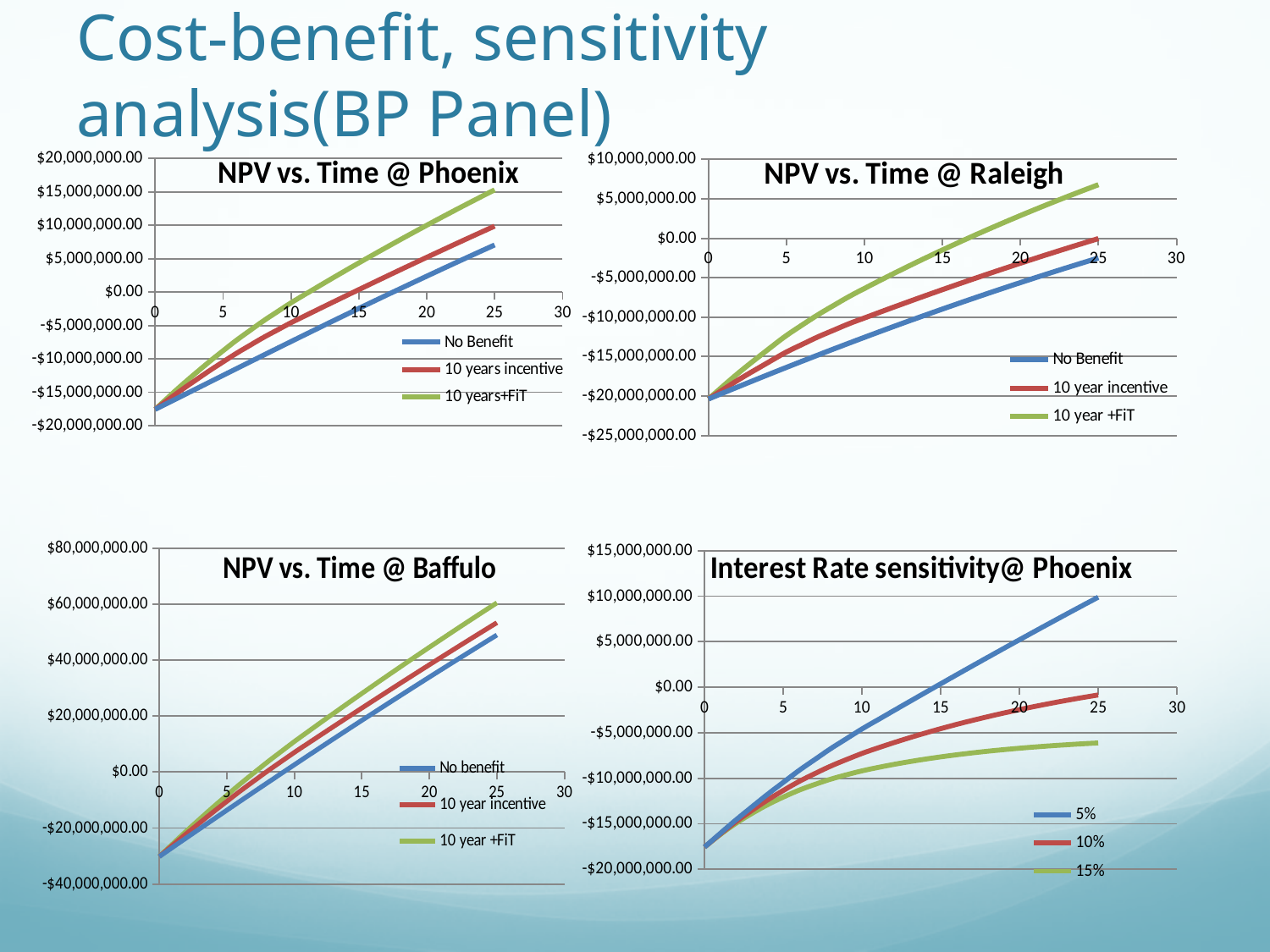
In 'NPV vs. Time @ Phoenix', does the 'No Benefit' line rise or fall as time increases along the x axis? rise In 'Interest Rate sensitivity@ Phoenix', at year 25, which series is higher: '5%' or '15%'? 5% In 'NPV vs. Time @ Raleigh', what are the legend entries? No Benefit, 10 year incentive, 10 year +FiT In 'Interest Rate sensitivity@ Phoenix', how many series does the legend list? 3 In 'Interest Rate sensitivity@ Phoenix', is the value of the '15%' series at year 25 greater or less than -$10,000,000.00? greater How many charts are shown on the slide? 4 In 'NPV vs. Time @ Phoenix', is the value of '10 years+FiT' at year 25 greater or less than $10,000,000.00? greater What kind of chart is 'NPV vs. Time @ Phoenix'? line chart In 'NPV vs. Time @ Baffulo', is the value of '10 year +FiT' at year 25 greater or less than $40,000,000.00? greater In 'NPV vs. Time @ Raleigh', at year 25, which series is higher: 'No Benefit' or '10 year +FiT'? 10 year +FiT In 'NPV vs. Time @ Phoenix', how many series does the legend list? 3